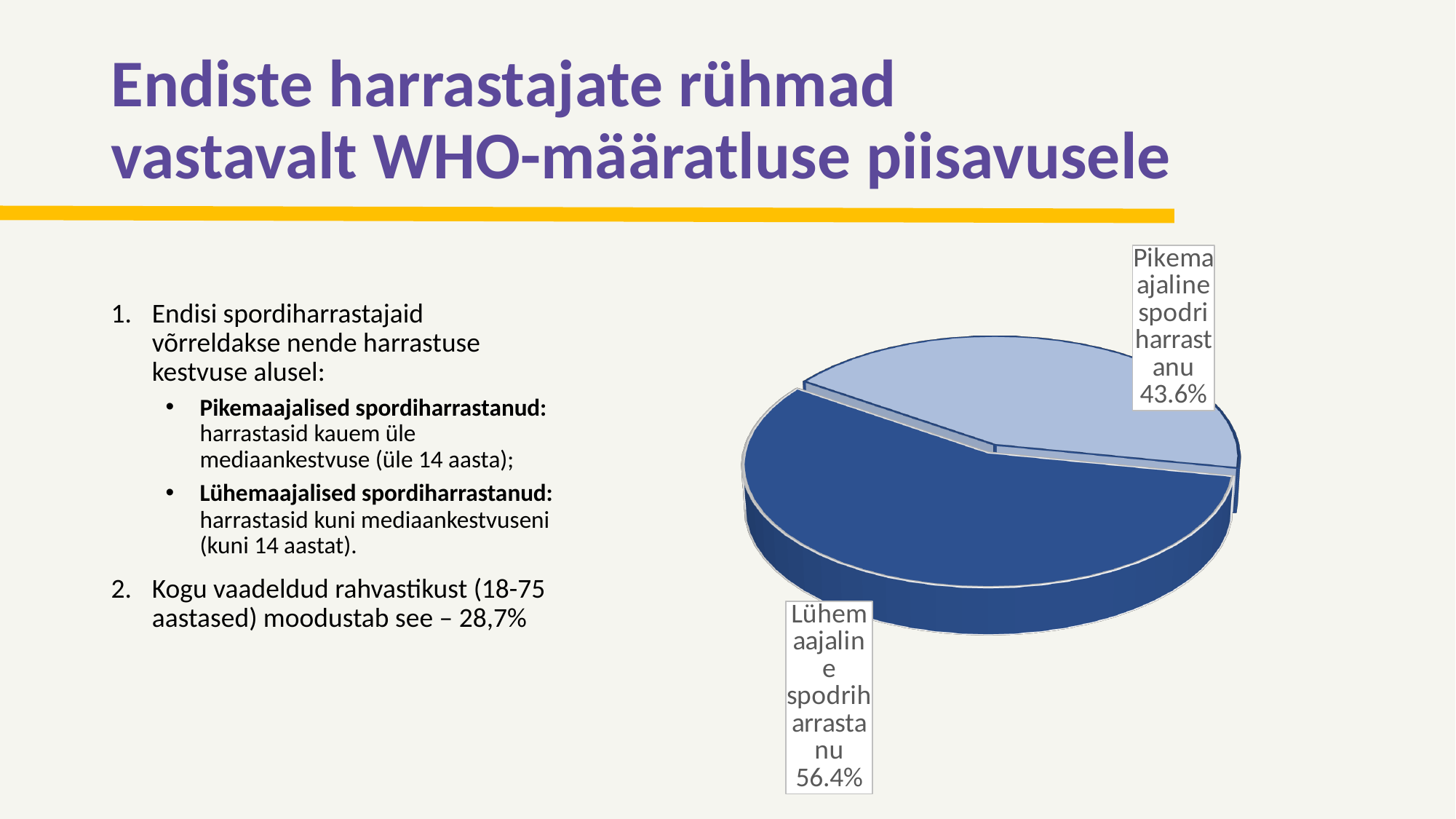
What kind of chart is shown on the slide? Pie chart Which slice of the pie chart is the smallest? Pikemaajaline spodriharrastanu Is the value for Lühemaajaline spodriharrastanu greater or less than 50%? greater What percentage does the pie chart show for Lühemaajaline spodriharrastanu? 56.4% Which is larger in the pie chart: Pikemaajaline spodriharrastanu or Lühemaajaline spodriharrastanu? Lühemaajaline spodriharrastanu Which slice of the pie chart is drawn in the darker blue colour? Lühemaajaline spodriharrastanu How many slices does the pie chart have? 2 By how many percentage points does the Lühemaajaline spodriharrastanu slice exceed the Pikemaajaline spodriharrastanu slice? 12.8 percentage points What do the two slice percentages in the pie chart add up to? 100% What percentage does the pie chart show for Pikemaajaline spodriharrastanu? 43.6% What share of the pie does the Pikemaajaline spodriharrastanu slice represent? 43.6% Which slice of the pie chart is the largest? Lühemaajaline spodriharrastanu